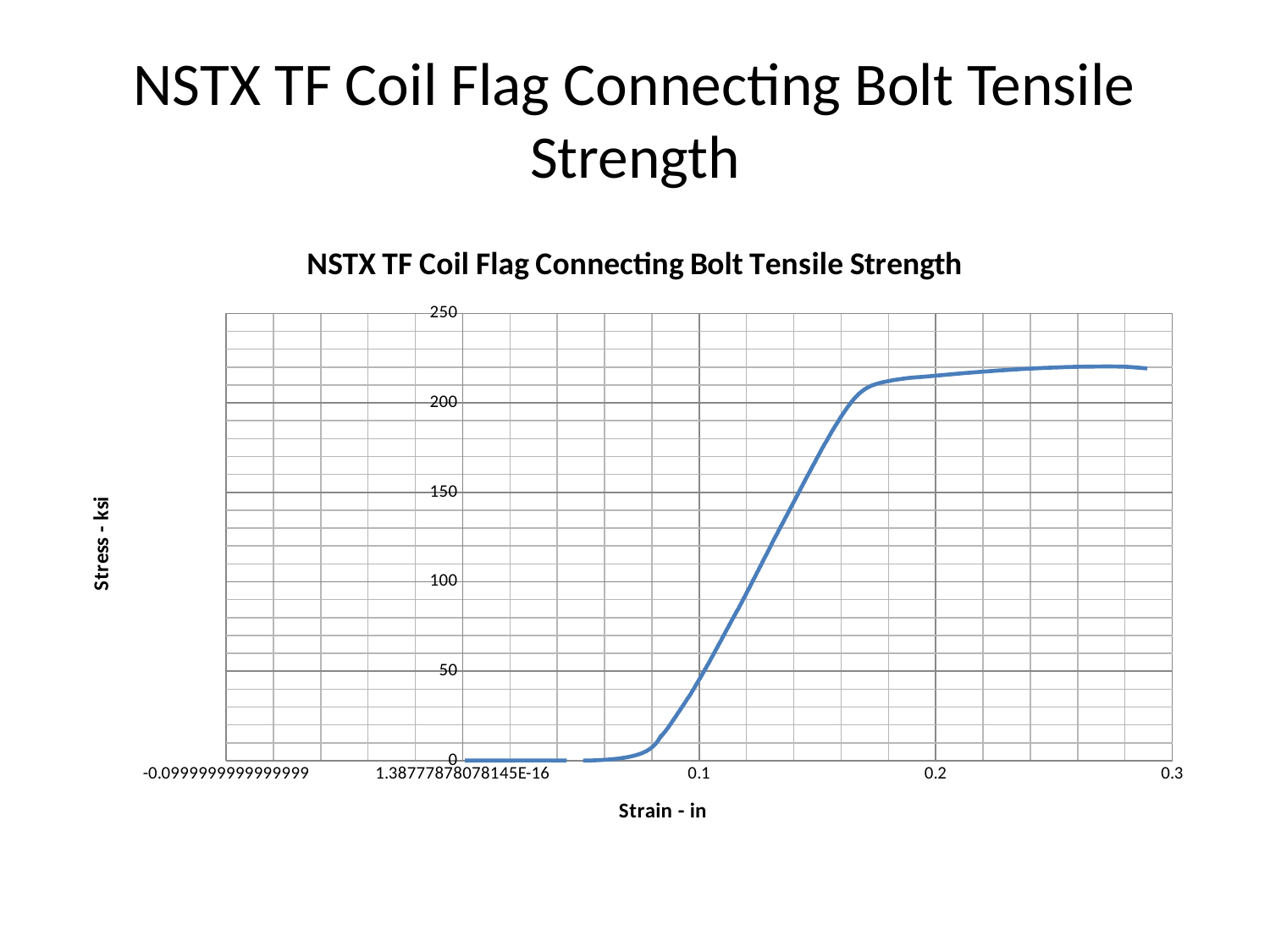
Is the stress value at a strain of 0.25 greater or less than 250? less Is the stress value at a strain of 0.2 greater or less than 200? greater How many lines are plotted on the chart? 1 What is the label of the vertical axis? Stress - ksi Is the stress value at a strain of 0.15 greater or less than 150? greater What kind of chart is shown on the slide? line chart Does the stress rise or fall as strain increases from 0.1 to 0.2? rise What is the highest value shown on the vertical axis? 250 What is the title of the chart? NSTX TF Coil Flag Connecting Bolt Tensile Strength